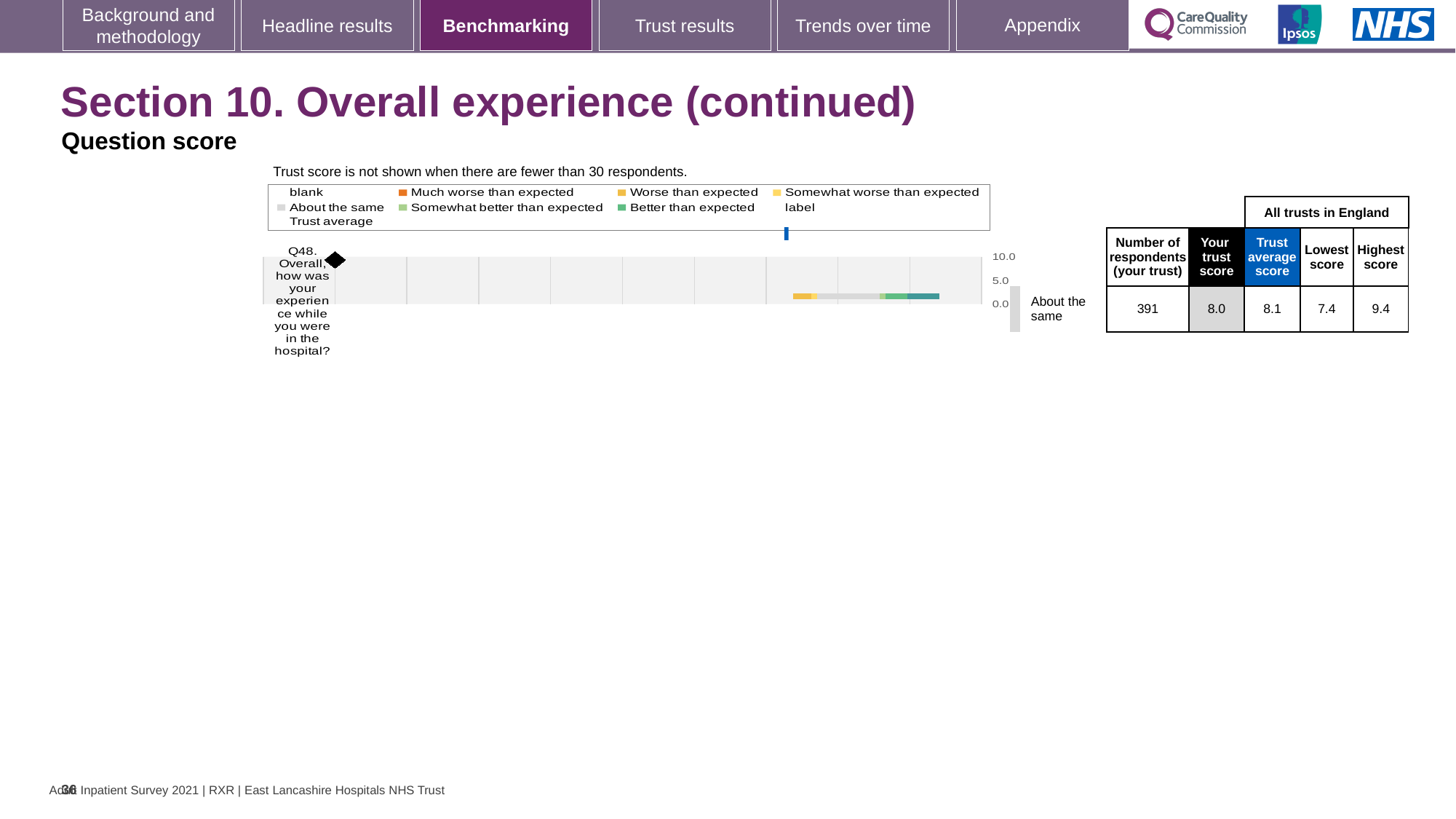
In the table beside the chart, what is the highest score among all trusts in England for Q48? 9.4 Which is larger for Q48: your trust score or the trust average score? Trust average score In the table beside the chart, what is the number of respondents for your trust for Q48? 391 In the table beside the chart, what is your trust score for Q48? 8.0 In the table beside the chart, what is the lowest score among all trusts in England for Q48? 7.4 What benchmark category is shown next to the chart for Q48? About the same How many survey questions are plotted in the chart? 1 What kind of chart is shown on the slide for Q48? bar chart In the table beside the chart, what is the trust average score for all trusts in England for Q48? 8.1 What is the difference between the highest score and the lowest score for Q48? 2.0 What is the maximum tick value shown on the chart's score axis? 10.0 Which question is plotted in the chart? Q48. Overall, how was your experience while you were in the hospital?